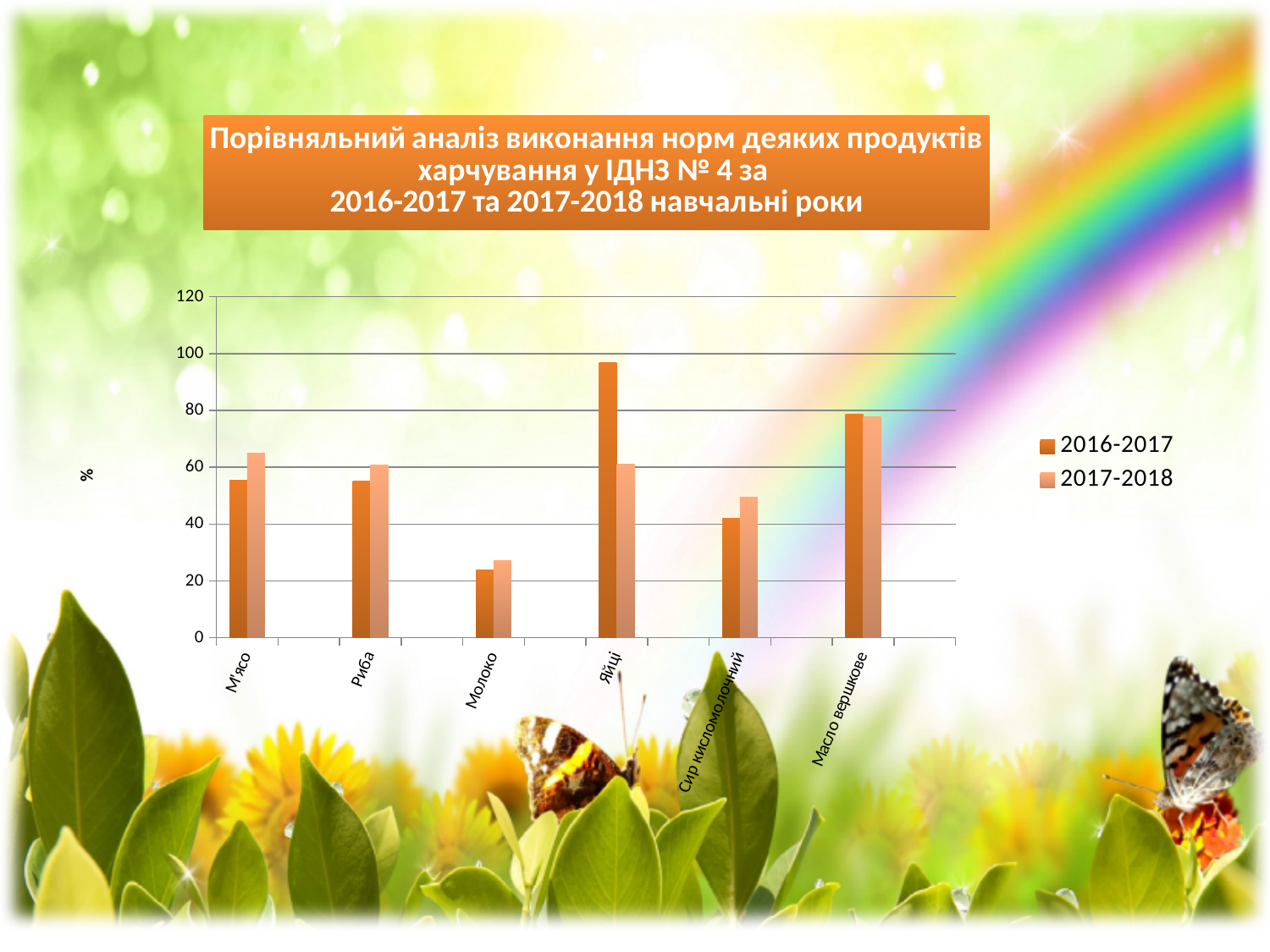
Is the 2016-2017 value for Яйці greater or less than 80? greater Which category has the lowest value for the 2016-2017 series? Молоко Is the 2016-2017 value for Молоко greater or less than 40? less What kind of chart is shown on the slide? bar chart How many series does the legend list? 2 Which category has the lowest value for the 2017-2018 series? Молоко Which category has the highest value for the 2017-2018 series? Масло вершкове For М'ясо, which series has the larger value, 2016-2017 or 2017-2018? 2017-2018 For Яйці, which series has the larger value, 2016-2017 or 2017-2018? 2016-2017 What are the two entries listed in the legend? 2016-2017 and 2017-2018 How many product categories are shown on the x axis? 6 Which category has the highest value for the 2016-2017 series? Яйці